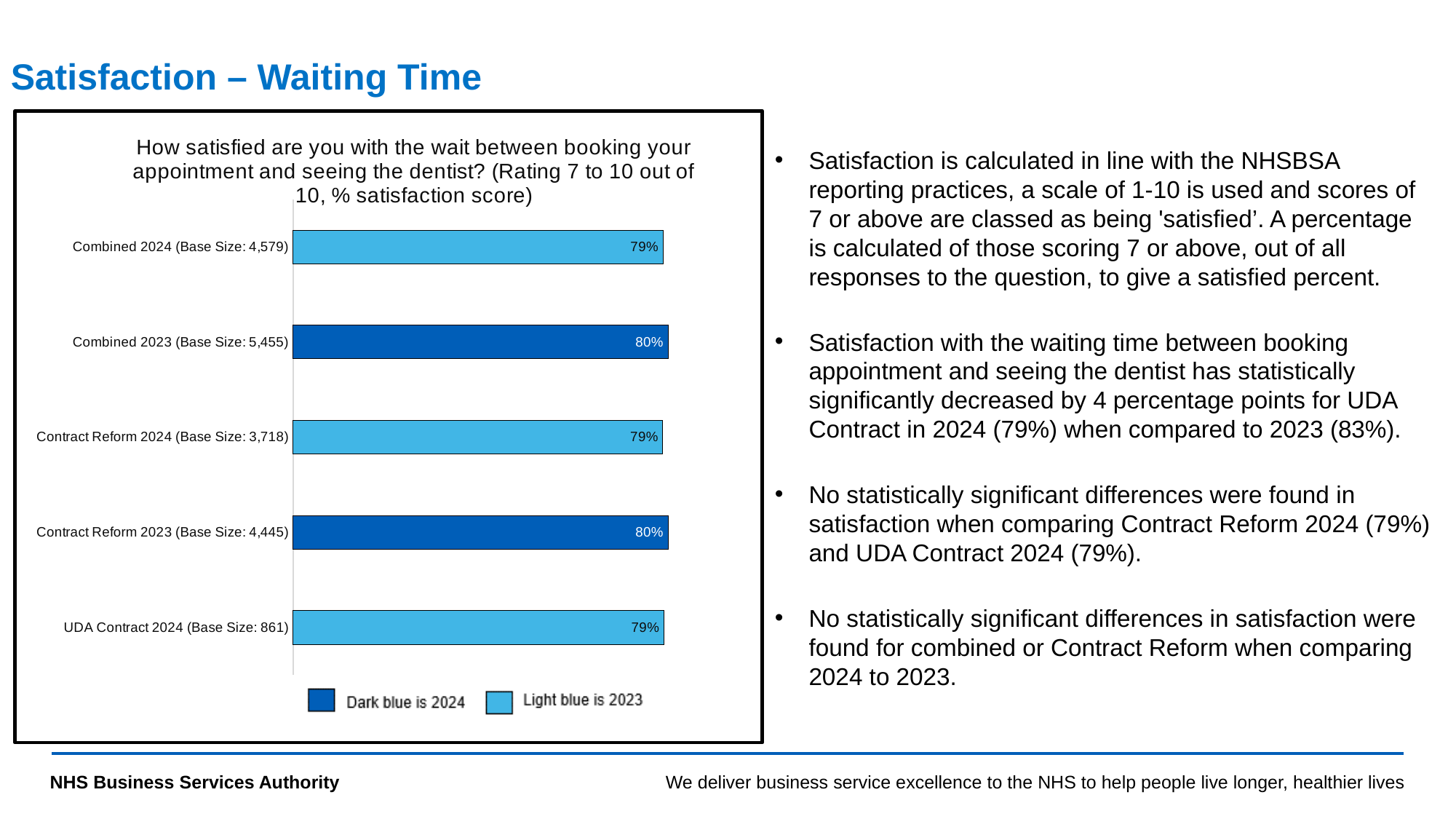
What is the satisfaction score for Combined 2023 (Base Size: 5,455)? 80% What is the satisfaction score for Combined 2024 (Base Size: 4,579)? 79% What type of chart is shown on the slide? Bar chart How many entries does the chart legend list? 2 What is the satisfaction score for Contract Reform 2024 (Base Size: 3,718)? 79% What is the satisfaction score for Contract Reform 2023 (Base Size: 4,445)? 80% What is the base size shown for UDA Contract 2024? 861 According to the legend, which year does light blue represent? 2023 What is the difference between the satisfaction scores for Combined 2023 and Combined 2024? 1 percentage point What is the satisfaction score for UDA Contract 2024 (Base Size: 861)? 79% Which has a higher satisfaction score, Contract Reform 2023 or Contract Reform 2024? Contract Reform 2023 How many bars are shown in the chart? 5